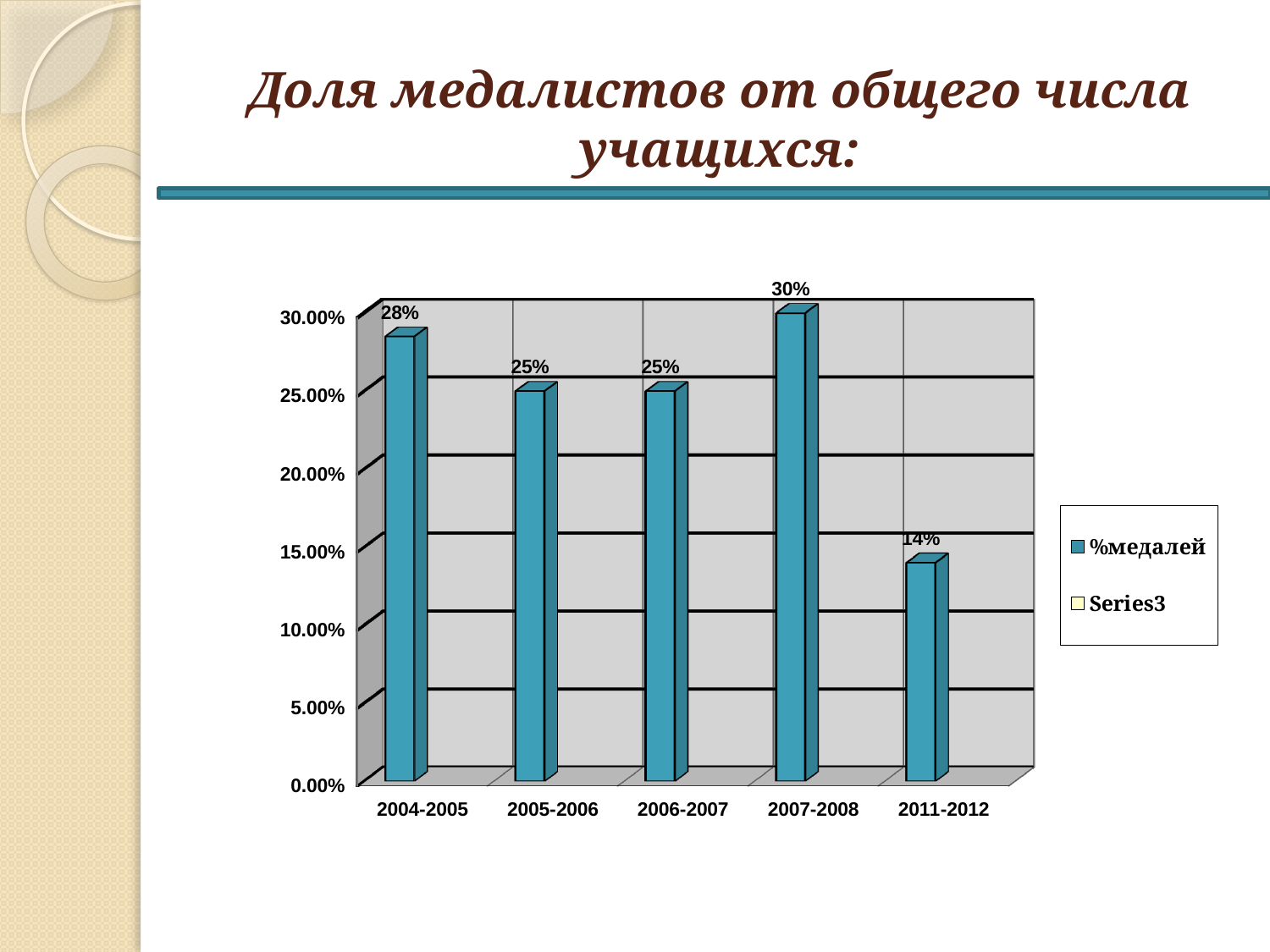
Is the value for 2011-2012 greater or less than 15.00%? less Which category has the lowest value? 2011-2012 How many series does the legend list? 2 Which is larger, the value for 2004-2005 or the value for 2005-2006? 2004-2005 What is the value for 2007-2008? 30% Which category has the highest value? 2007-2008 What is the value for 2004-2005? 28% How many categories are shown on the x axis? 5 What is the name of the first series listed in the legend? %медалей What kind of chart is shown on the slide? bar chart What is the difference between the values for 2007-2008 and 2011-2012? 16% What is the value for 2011-2012? 14%